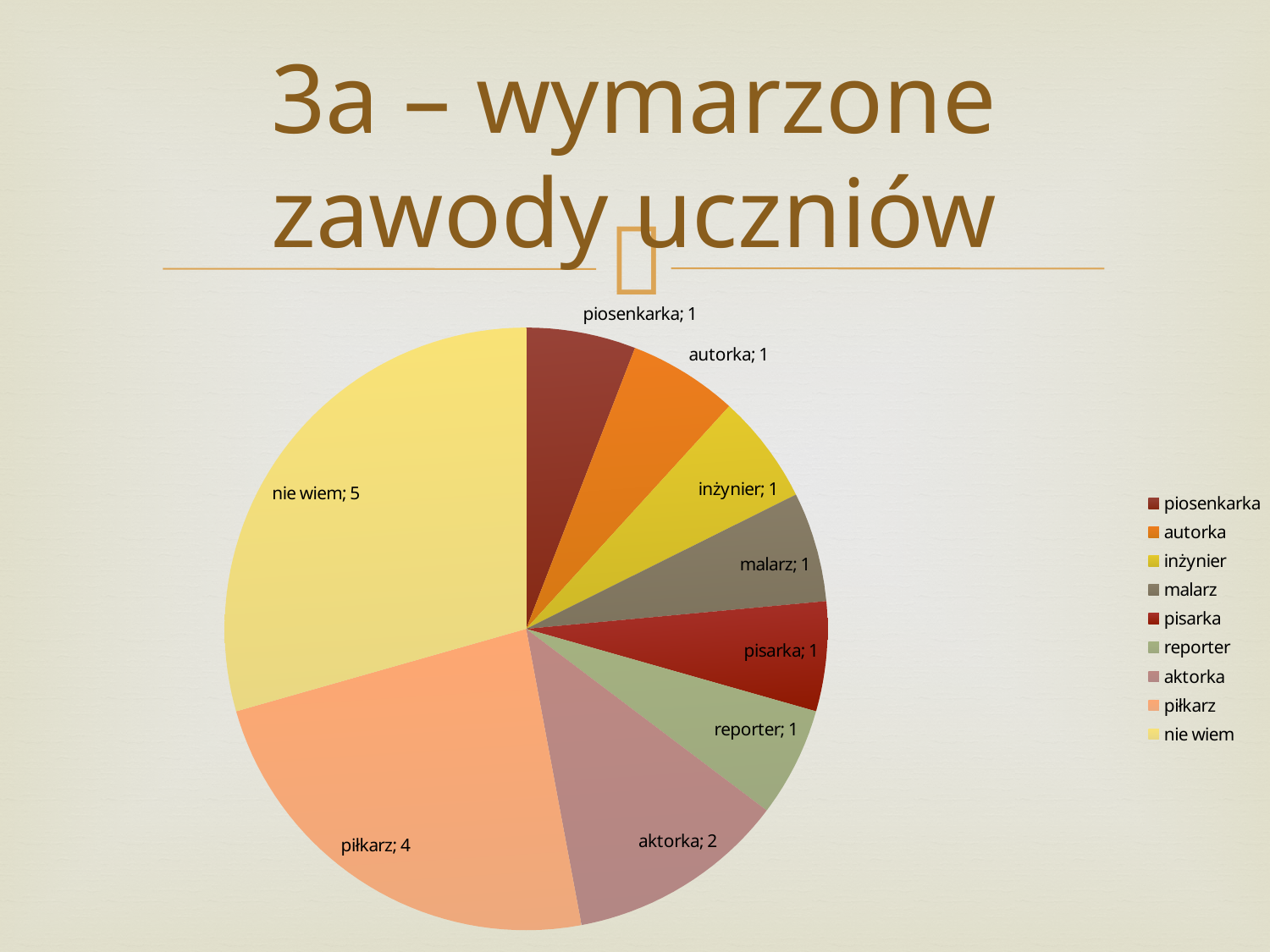
What is the difference between the "nie wiem" and "piłkarz" values? 1 What is the value for the "aktorka" slice? 2 What is the value for the "reporter" slice? 1 How many categories does the pie chart have? 9 Which is larger, the value for "aktorka" or the value for "malarz"? aktorka How many students answered "nie wiem"? 5 How many entries does the legend list? 9 What kind of chart is shown on the slide? pie chart What is the difference between the "piłkarz" and "aktorka" values? 2 What is the title of the slide containing the chart? 3a – wymarzone zawody uczniów Which category has the largest slice of the pie? nie wiem What is the value for the "piłkarz" slice? 4